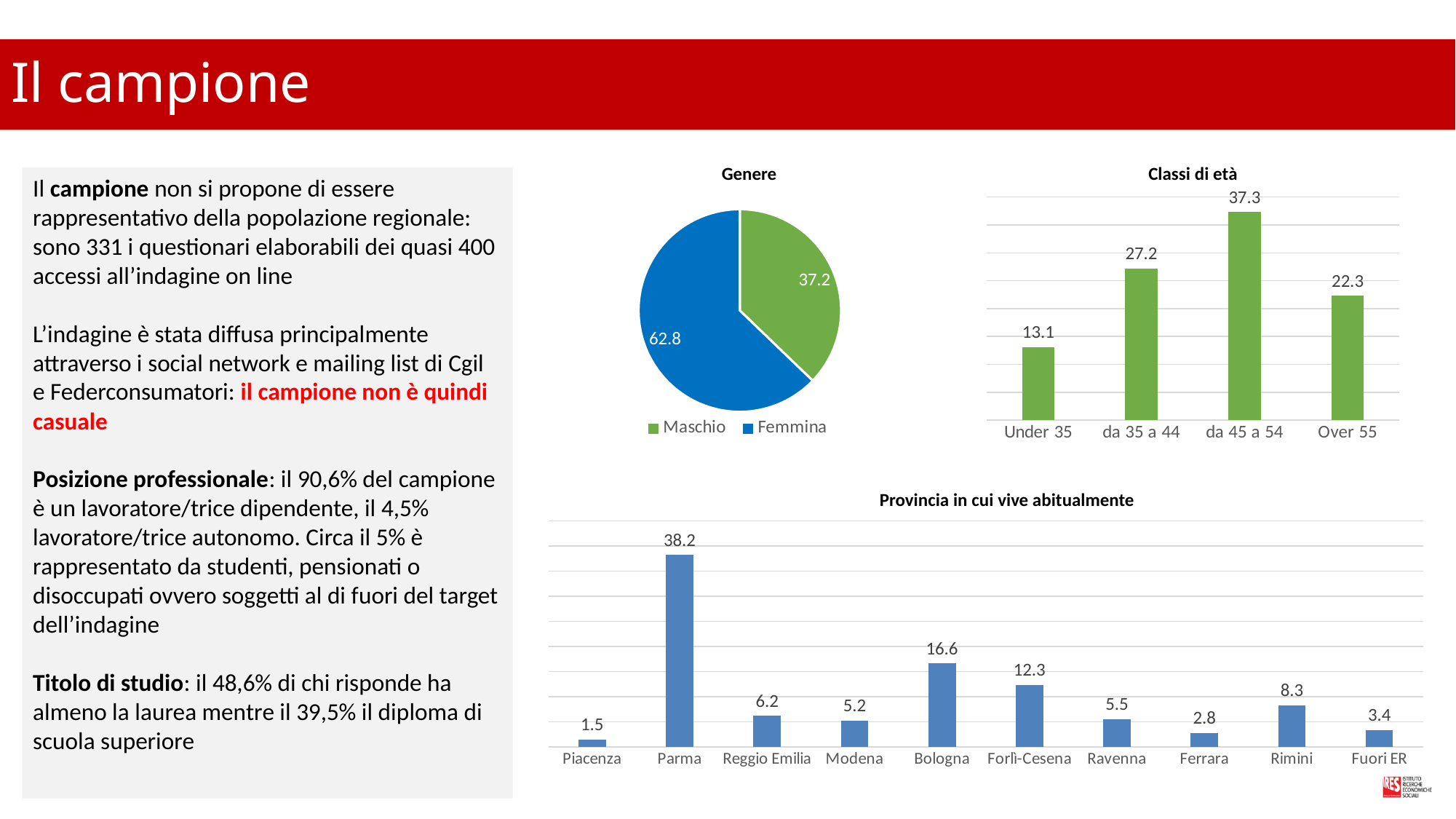
In the 'Classi di età' chart, which age class has the lowest value? Under 35 In the 'Provincia in cui vive abitualmente' chart, which province has the highest value? Parma In the 'Provincia in cui vive abitualmente' chart, what is the value for Bologna? 16.6 In the 'Genere' chart, what is the value for Maschio? 37.2 What kind of chart is the 'Genere' chart? Pie chart In the 'Classi di età' chart, which age class has the highest value? da 45 a 54 In the 'Classi di età' chart, what is the difference between da 45 a 54 and Over 55? 15.0 In the 'Genere' chart, what is the value for Femmina? 62.8 In the 'Classi di età' chart, what is the value for da 35 a 44? 27.2 In the 'Provincia in cui vive abitualmente' chart, how many categories are shown on the x axis? 10 How many entries does the legend of the 'Genere' chart list? 2 In the 'Provincia in cui vive abitualmente' chart, which is larger, the value for Rimini or the value for Ravenna? Rimini